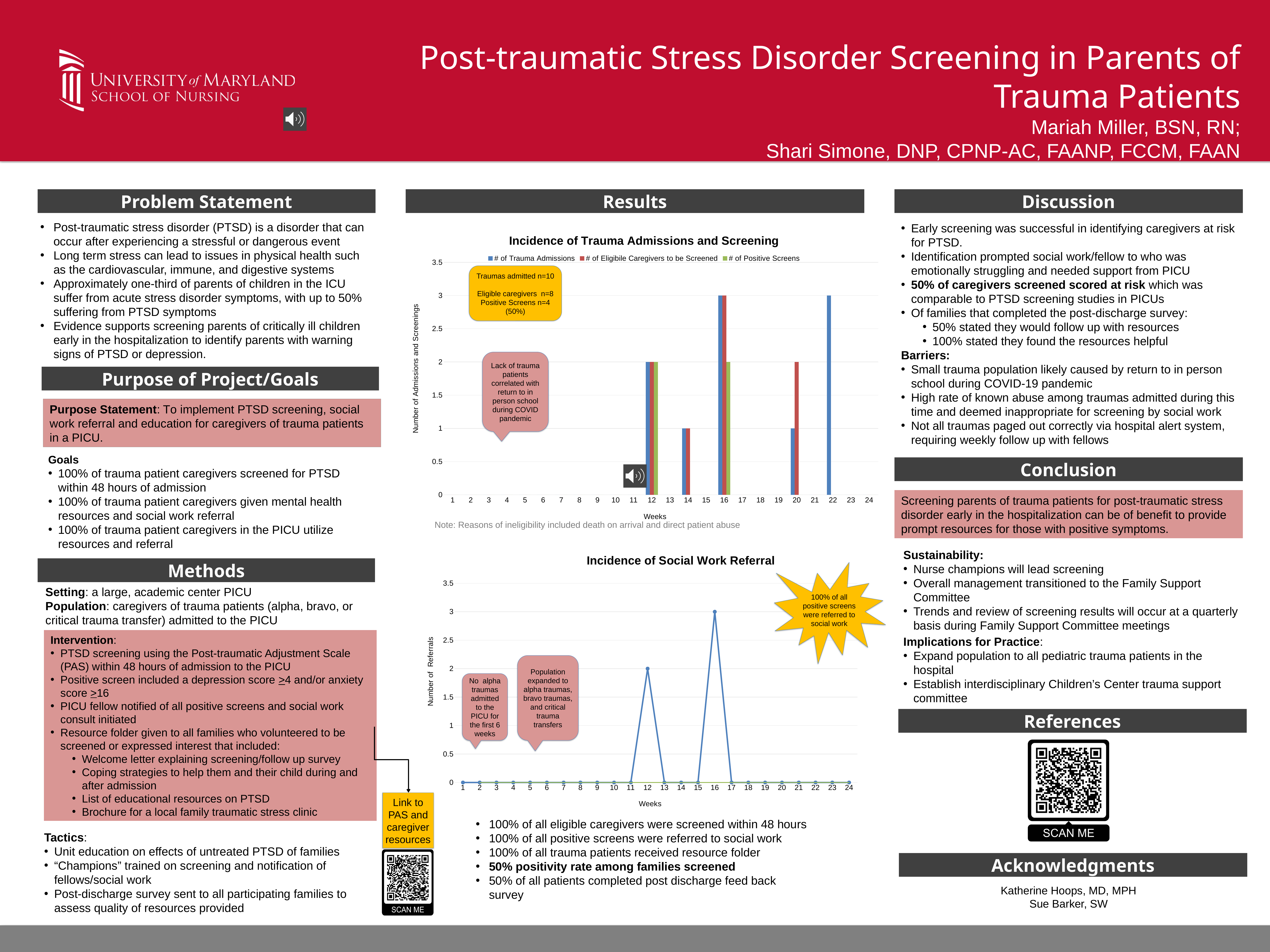
What kind of chart is the 'Incidence of Trauma Admissions and Screening' chart? bar chart How many weeks are shown on the x axis of the 'Incidence of Social Work Referral' chart? 24 In the 'Incidence of Trauma Admissions and Screening' chart, what is the # of Trauma Admissions in week 22? 3 In the 'Incidence of Social Work Referral' chart, what is the number of referrals in week 16? 3 In the 'Incidence of Social Work Referral' chart, what is the difference between the referrals in week 16 and week 12? 1 In the 'Incidence of Trauma Admissions and Screening' chart, is the # of Trauma Admissions in week 12 greater or less than 1? greater In the 'Incidence of Social Work Referral' chart, what is the number of referrals in week 12? 2 How many series does the legend of the 'Incidence of Trauma Admissions and Screening' chart list? 3 What kind of chart is the 'Incidence of Social Work Referral' chart? line chart In the 'Incidence of Social Work Referral' chart, which week has the highest number of referrals? Week 16 In the 'Incidence of Trauma Admissions and Screening' chart, which week has more trauma admissions, week 14 or week 16? Week 16 In the 'Incidence of Trauma Admissions and Screening' chart, what is the # of Positive Screens in week 16? 2